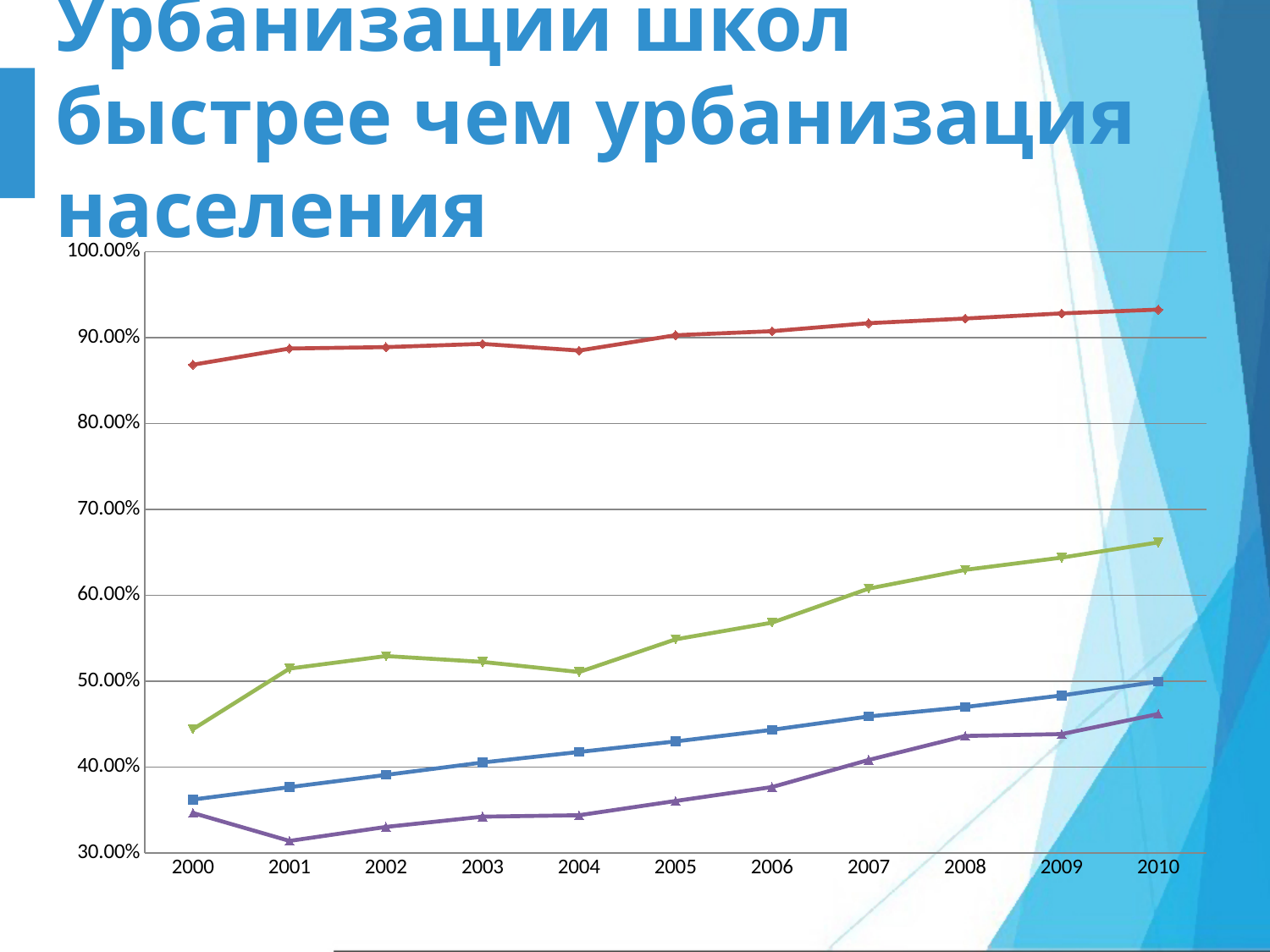
What is the first year shown on the x axis? 2000 What kind of chart is shown on the slide? line chart Is the value of the blue line in 2010 greater or less than 40.00%? greater Is the value of the green line in 2010 greater or less than 70.00%? less In 2010, which is higher: the green line or the blue line? the green line What is the last year shown on the x axis? 2010 Is the value of the red line in 2000 greater or less than 80.00%? greater Which coloured line has the highest values across all years? the red line Does the green line generally rise or fall from 2004 to 2010? rise Which coloured line has the lowest value in 2001? the purple line How many years are shown along the x axis of the chart? 11